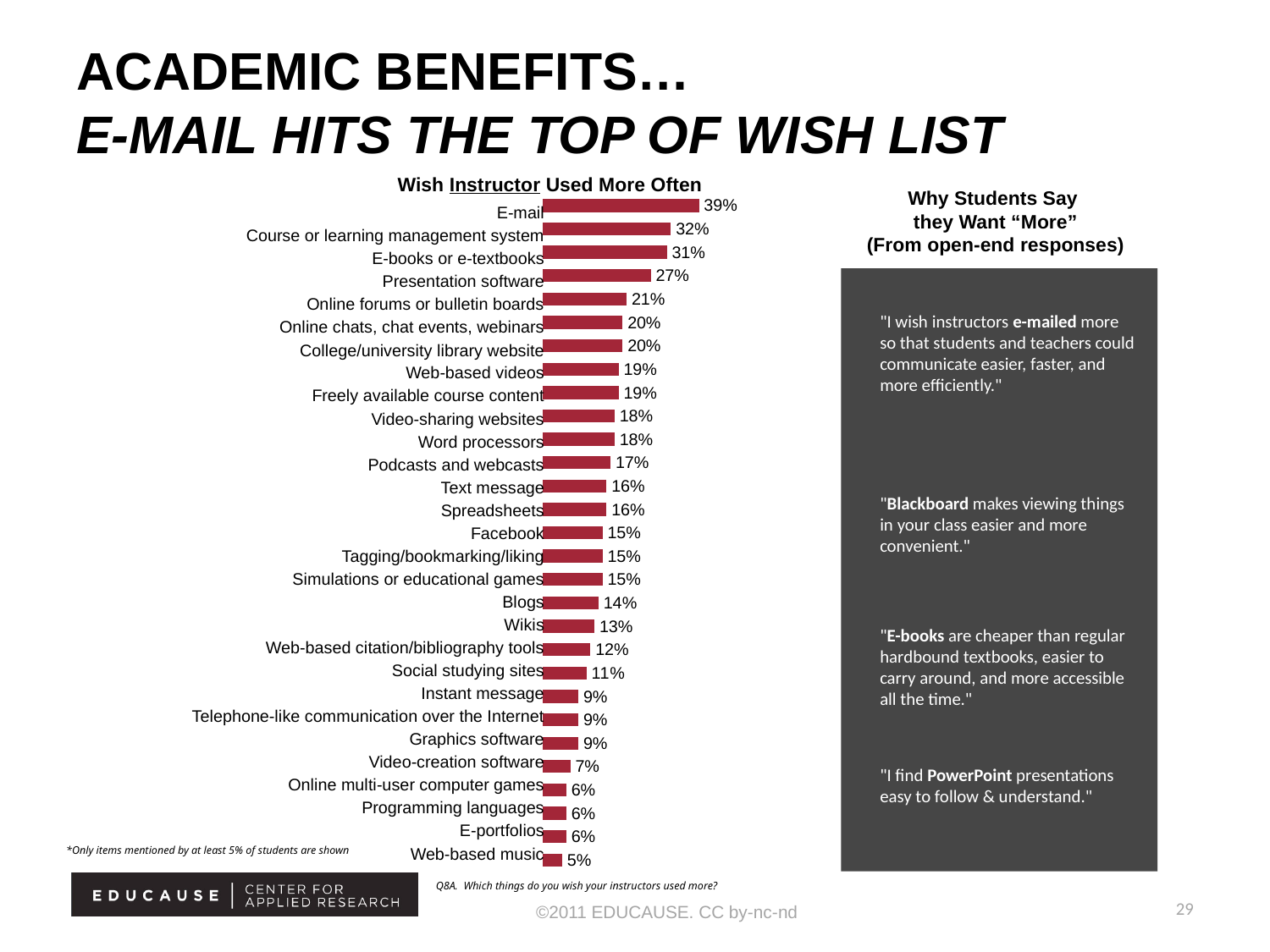
What type of chart is shown on the slide? Bar chart Which item has the highest percentage in the chart? E-mail What is the difference between the values for E-mail and Course or learning management system? 7% What is the title of the chart? Wish Instructor Used More Often What is the value shown for Wikis? 13% Which has a higher value, Online forums or bulletin boards or Spreadsheets? Online forums or bulletin boards What is the difference between the values for E-books or e-textbooks and Blogs? 17% What is the value shown for Presentation software? 27% What percentage of students wish instructors used e-mail more often? 39% Which item has the lowest percentage in the chart? Web-based music Which has a higher value, Facebook or Social studying sites? Facebook How many items are listed in the chart? 29